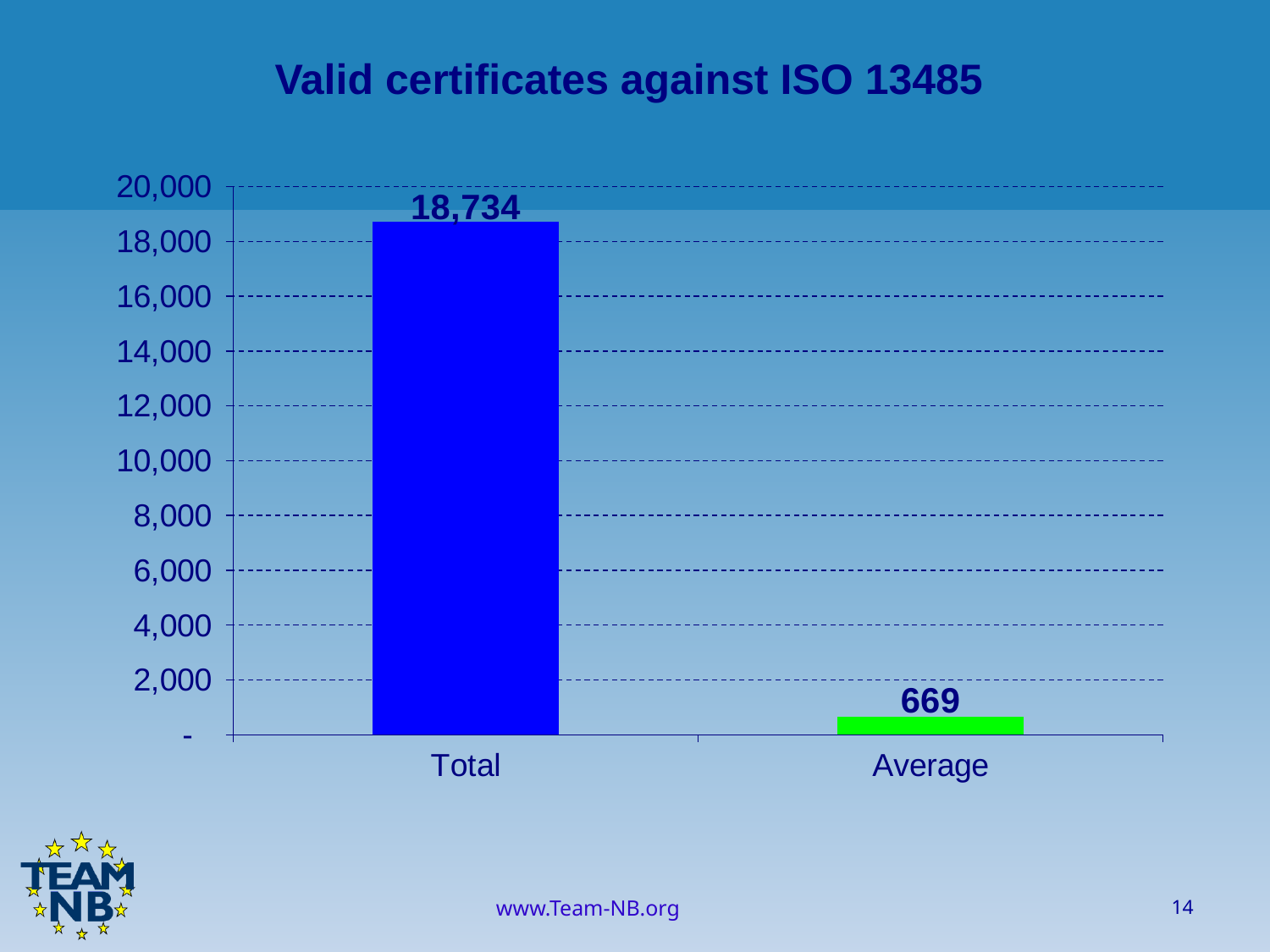
What kind of chart is shown on the slide? bar chart What is the value for Average? 669 Is the value for Average greater or less than 2,000? less What is the difference between the Total and Average values? 18,065 How many categories are shown on the x axis? 2 Which category has the highest value? Total Is the value for Total greater or less than 18,000? greater What is the title of the chart? Valid certificates against ISO 13485 Which is larger, the value for Total or the value for Average? Total What colour is the bar for Average? green Which category has the lowest value? Average What is the value for Total? 18,734